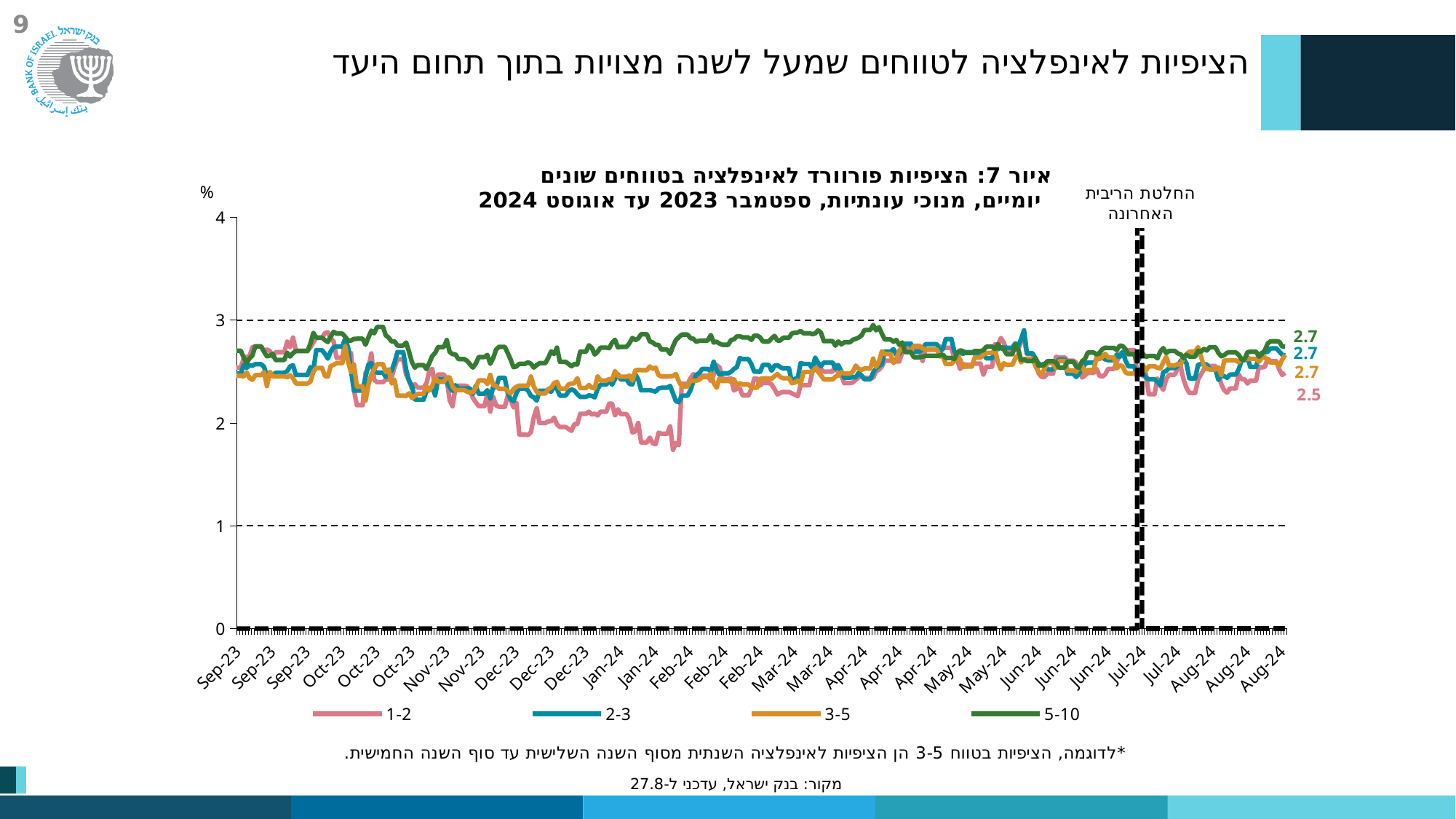
What unit is shown on the y axis of the chart? % Is the value of the 5-10 series around Apr-24 greater or less than 3? less What are the four series listed in the legend? 1-2, 2-3, 3-5, 5-10 What is the latest value labeled at the right end of the 1-2 series? 2.5 What is the latest value labeled at the right end of the 2-3 series? 2.7 What is the difference between the end values of the 5-10 series and the 1-2 series? 0.2 What is the latest value labeled at the right end of the 5-10 series? 2.7 At the right end of the chart, which is larger: the 3-5 series or the 1-2 series? 3-5 How many series does the legend list? 4 What kind of chart is shown on the slide? line chart Which series has the lowest value at the right end of the chart? 1-2